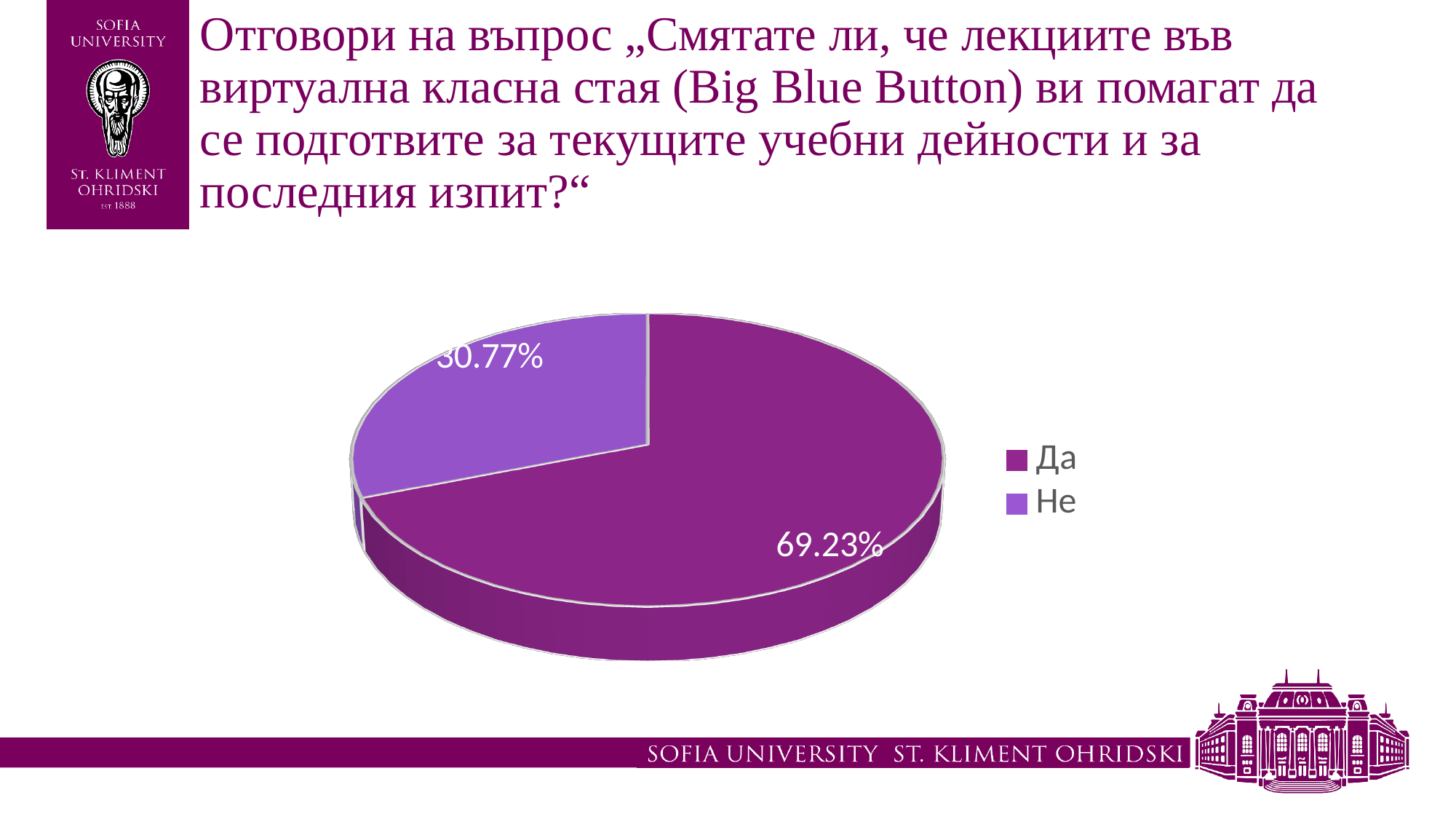
Which slice is the largest? Да What share of the pie does "Да" take? 69.23% Which slice is the smallest? Не Is the share for "Да" greater or less than 50%? greater What share of the pie does "Не" take? 30.77% Which is larger, the "Да" slice or the "Не" slice? Да How many slices does the pie chart have? 2 What colour is the "Не" slice? light purple What kind of chart is shown on the slide? pie chart How many entries does the legend list? 2 What is the difference in percentage points between the "Да" and "Не" slices? 38.46